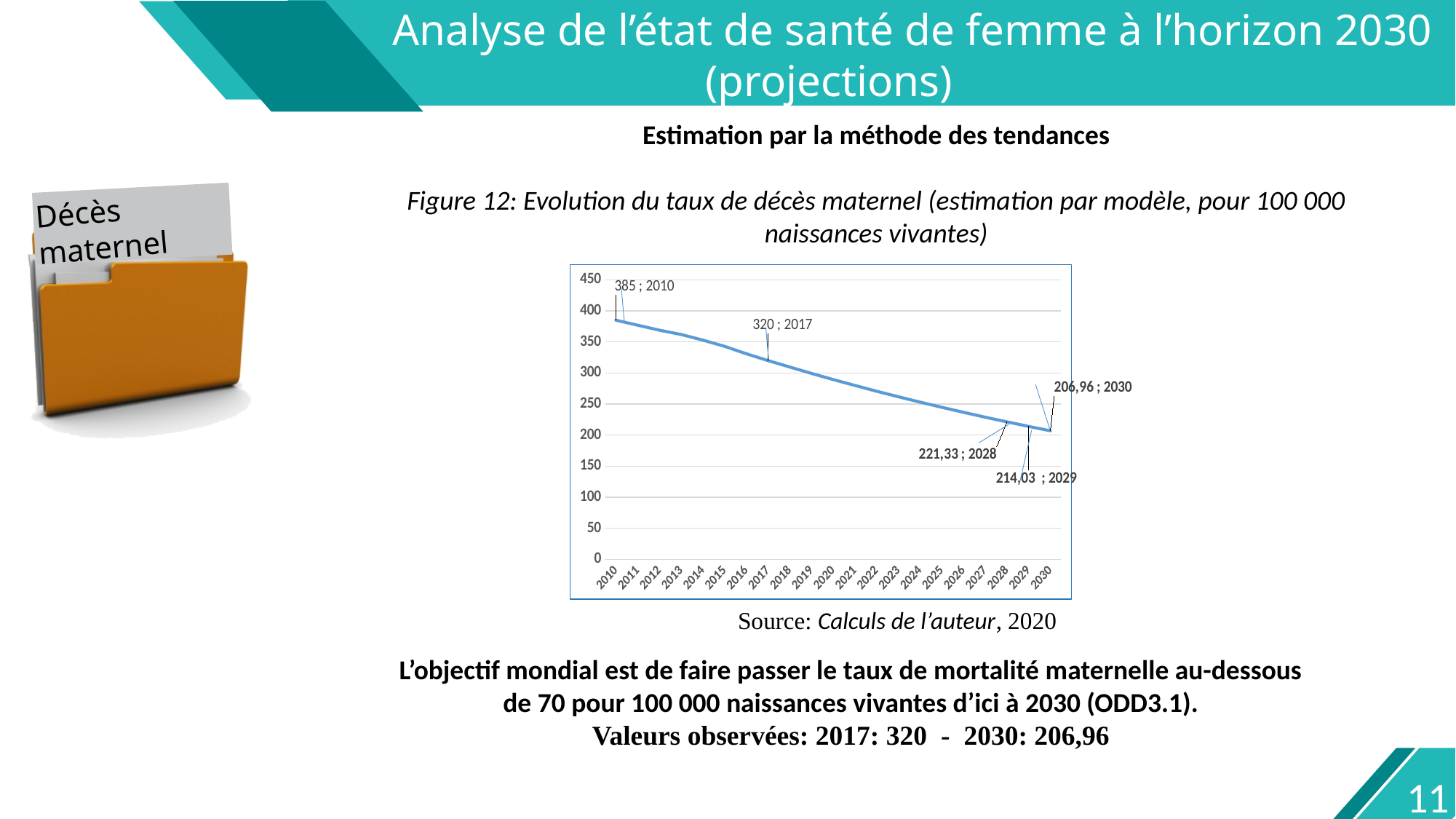
What is the difference between the 2010 value and the 2017 value? 65 What is the value labelled for 2029? 214,03 What is the value labelled for 2017? 320 What type of chart is shown in Figure 12? line chart Is the value for 2020 greater or less than 250? greater What is the value labelled for 2028? 221,33 What is the maternal death rate value labelled for 2010? 385 Which year has the lowest value on the chart? 2030 Which year has the highest value on the chart? 2010 What is the projected value labelled for 2030? 206,96 How many years are shown on the x axis of the chart? 21 Does the value rise or fall from 2010 to 2030? fall